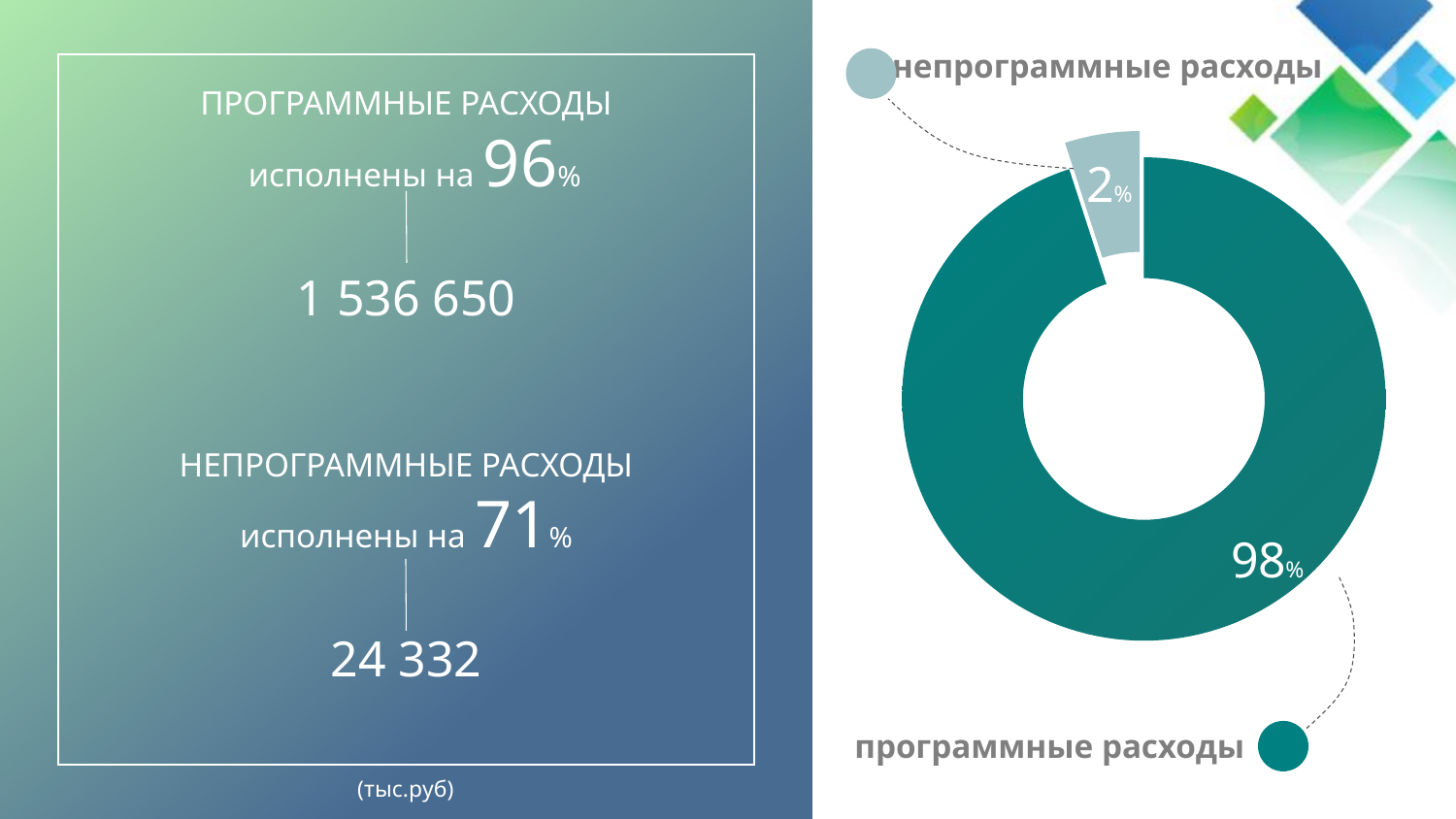
What share of the donut chart is labelled "непрограммные расходы"? 2% What do the two slices of the donut chart add up to? 100% Which category has the smallest slice in the donut chart? непрограммные расходы How many slices does the donut chart have? 2 Which category has the largest slice in the donut chart? программные расходы What share of the donut chart is labelled "программные расходы"? 98% What colour is the "непрограммные расходы" slice in the donut chart? Light grey-blue What is the difference in percentage points between the "программные расходы" slice and the "непрограммные расходы" slice? 96 What kind of chart is shown on the right side of the slide? Donut (pie) chart Which slice is larger in the donut chart: "программные расходы" or "непрограммные расходы"? программные расходы What colour is the "программные расходы" slice in the donut chart? Dark teal